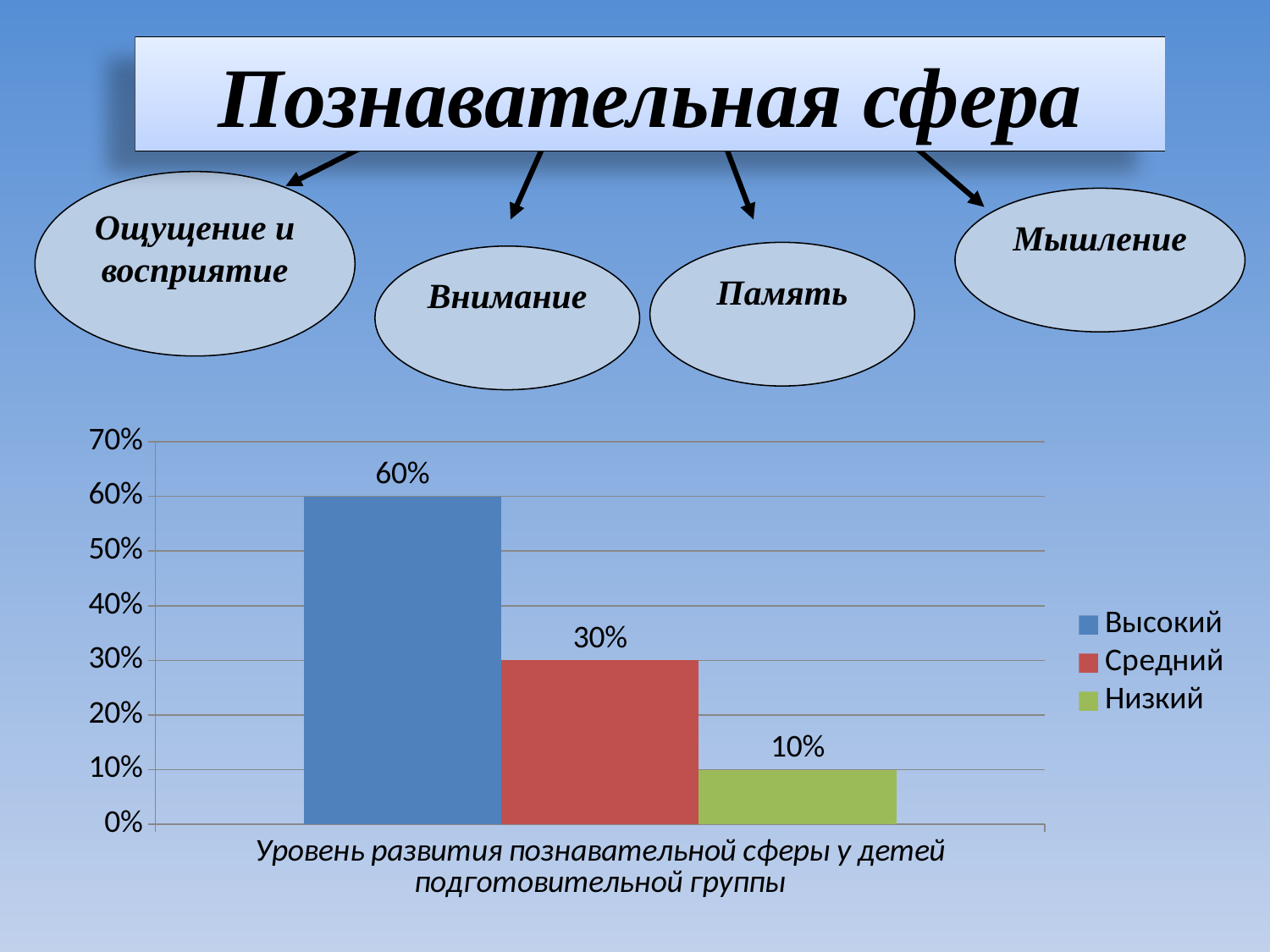
Which series has the lowest value? Низкий How many series does the legend list? 3 What is the difference between the values for Средний and Низкий? 20% Which series has the highest value? Высокий What is the category label shown under the bars? Уровень развития познавательной сферы у детей подготовительной группы What is the value for Низкий? 10% Which is larger, the value for Средний or the value for Низкий? Средний What is the value for Средний? 30% What kind of chart is shown on the slide? bar chart What is the difference between the values for Высокий and Средний? 30% What is the value for Высокий? 60% Is the value for Высокий greater or less than 50%? greater